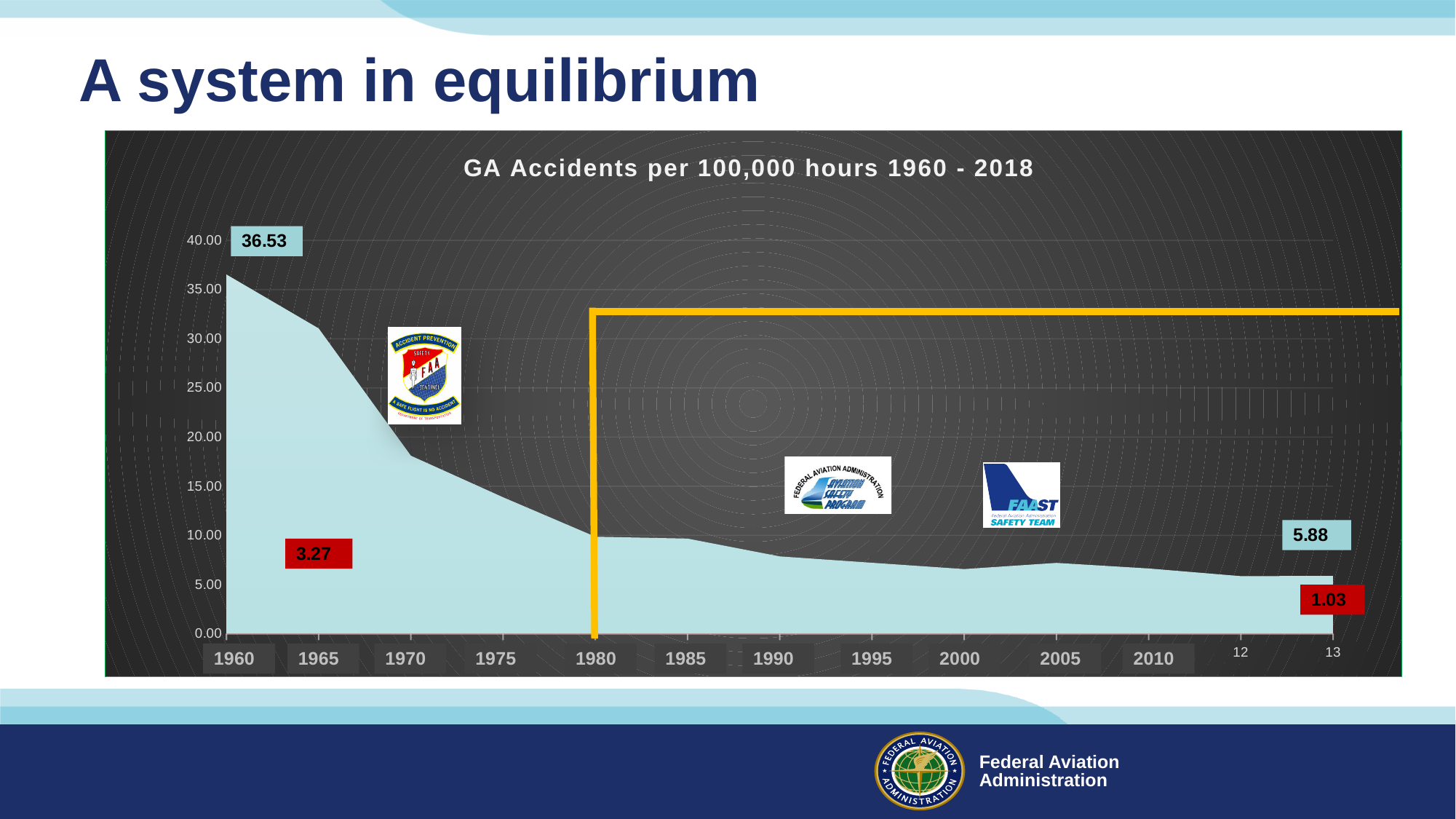
Is the value for 1970 greater or less than 20.00? less Which is larger, the value for 1960 or the value for 2010? 1960 Is the value for 1980 greater or less than 15.00? less What is the title of the chart? GA Accidents per 100,000 hours 1960 - 2018 What is the data label shown at the start of the series in 1960? 36.53 What is the highest tick value shown on the vertical axis? 40.00 What is the light blue data label shown at the right end of the series? 5.88 What kind of chart is shown on the slide? area chart Which year has the highest accident rate on the chart? 1960 Do the accident rate values rise or fall from 1960 to 2018? fall What is the difference between the 36.53 label and the 5.88 label? 30.65 Is the value for 1965 greater or less than 25.00? greater